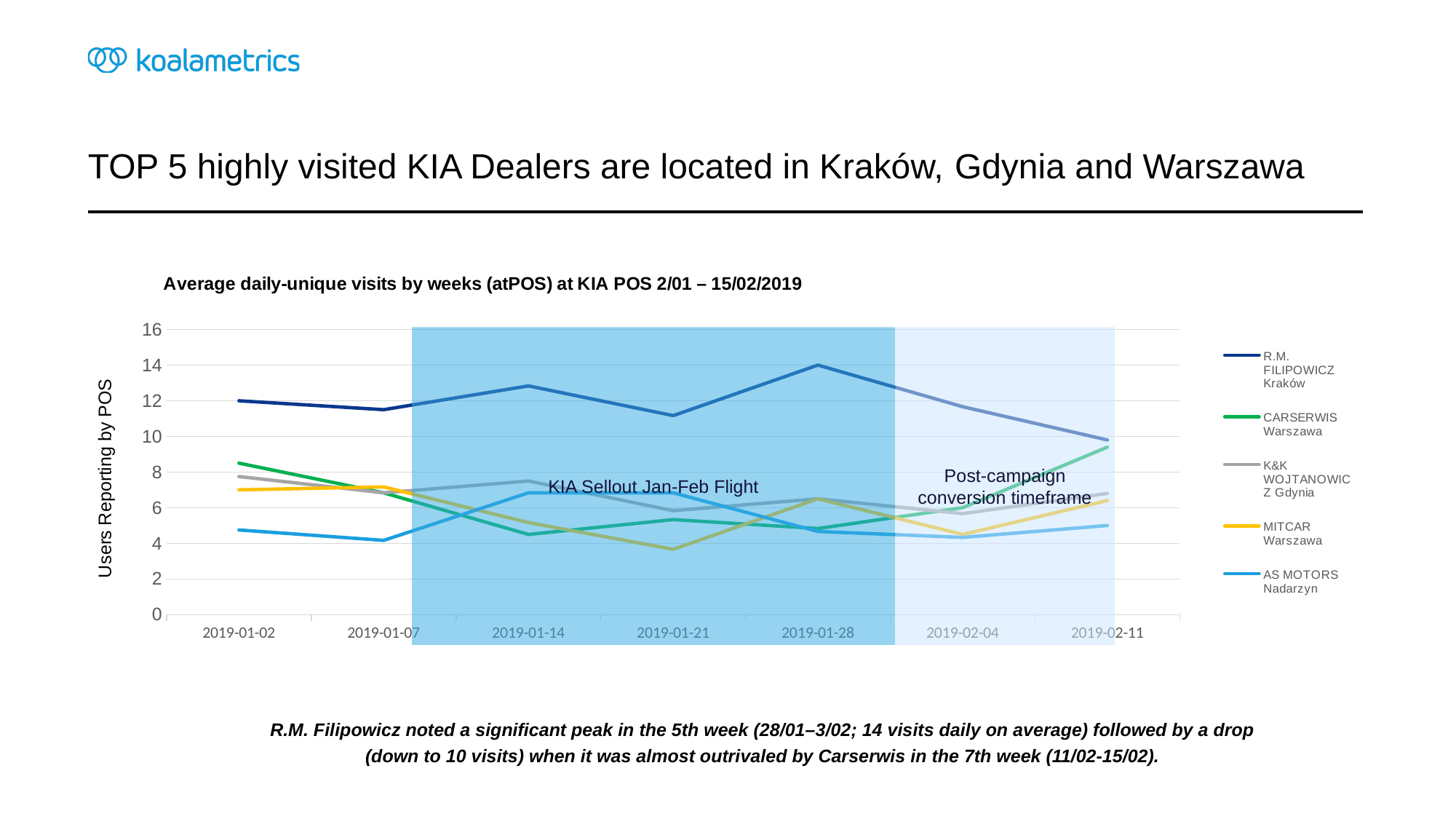
How many dates are shown along the x axis? 7 Does the value for R.M. FILIPOWICZ Kraków rise or fall from 2019-01-28 to 2019-02-11? fall What is the value for R.M. FILIPOWICZ Kraków at 2019-01-28? 14 Which dealer has the lowest value at 2019-01-21? MITCAR Warszawa Is the value for CARSERWIS Warszawa at 2019-01-02 greater or less than 6? greater Which dealer has the highest value at 2019-01-28? R.M. FILIPOWICZ Kraków At 2019-02-11, which is larger: CARSERWIS Warszawa or MITCAR Warszawa? CARSERWIS Warszawa How many series does the legend list? 5 Is the value for AS MOTORS Nadarzyn at 2019-01-07 greater or less than 6? less What is the label on the y axis of the chart? Users Reporting by POS Is the value for K&K WOJTANOWICZ Gdynia at 2019-01-14 greater or less than 6? greater What kind of chart is shown on the slide? line chart